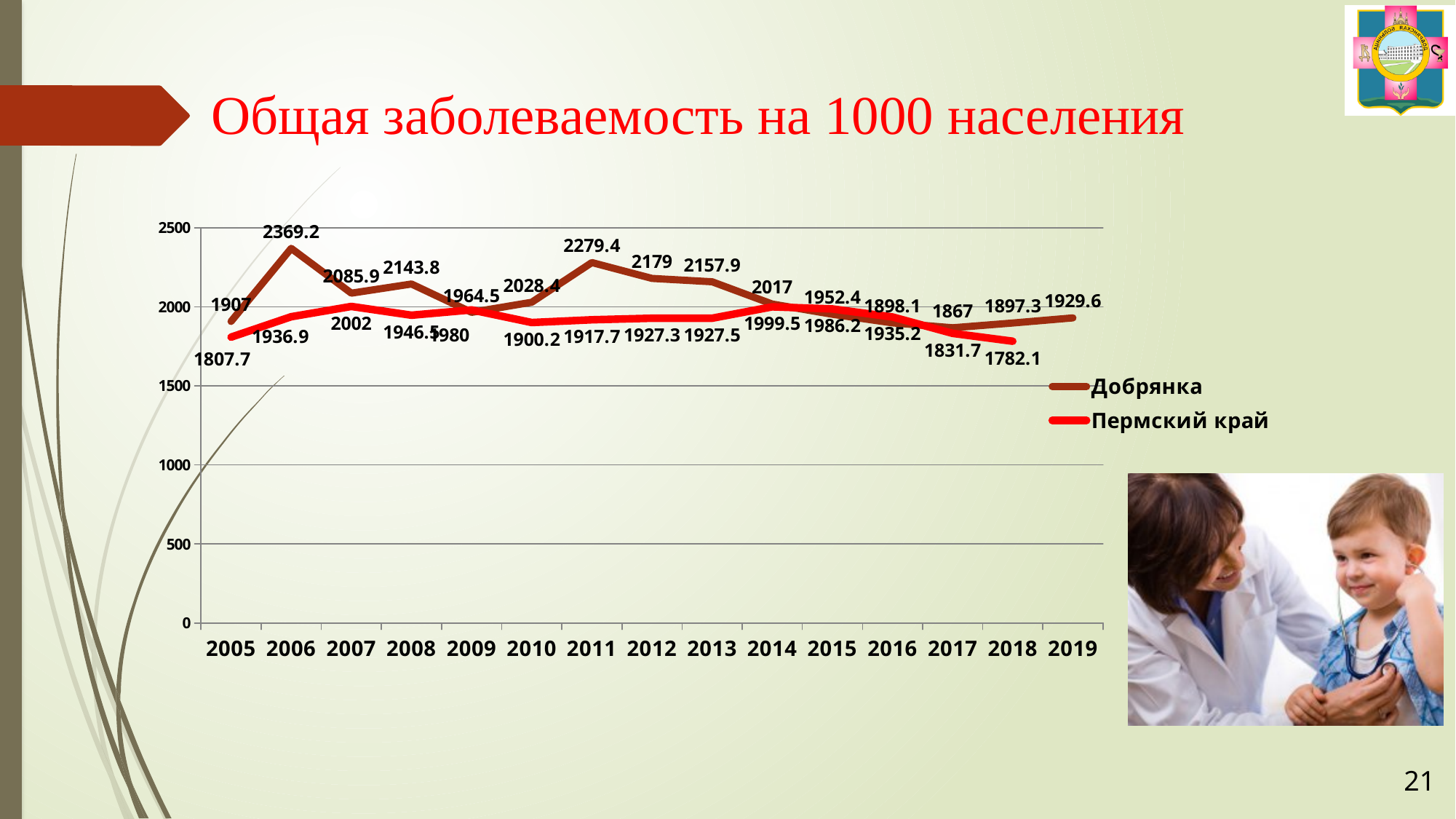
What is the difference between Добрянка and Пермский край in 2006? 432.3 In which year does the Добрянка series reach its highest value? 2006 How many years are shown on the x axis? 15 What is the value for Пермский край in 2018? 1782.1 What is the value for Добрянка in 2019? 1929.6 Which series has the larger value in 2013, Добрянка or Пермский край? Добрянка In which year does the Пермский край series reach its lowest value? 2018 What is the value for Добрянка in 2006? 2369.2 What kind of chart is shown on the slide? line chart How many series does the legend list? 2 Is the value for Добрянка in 2011 greater or less than 2000? greater What is the difference between Добрянка and Пермский край in 2011? 361.7